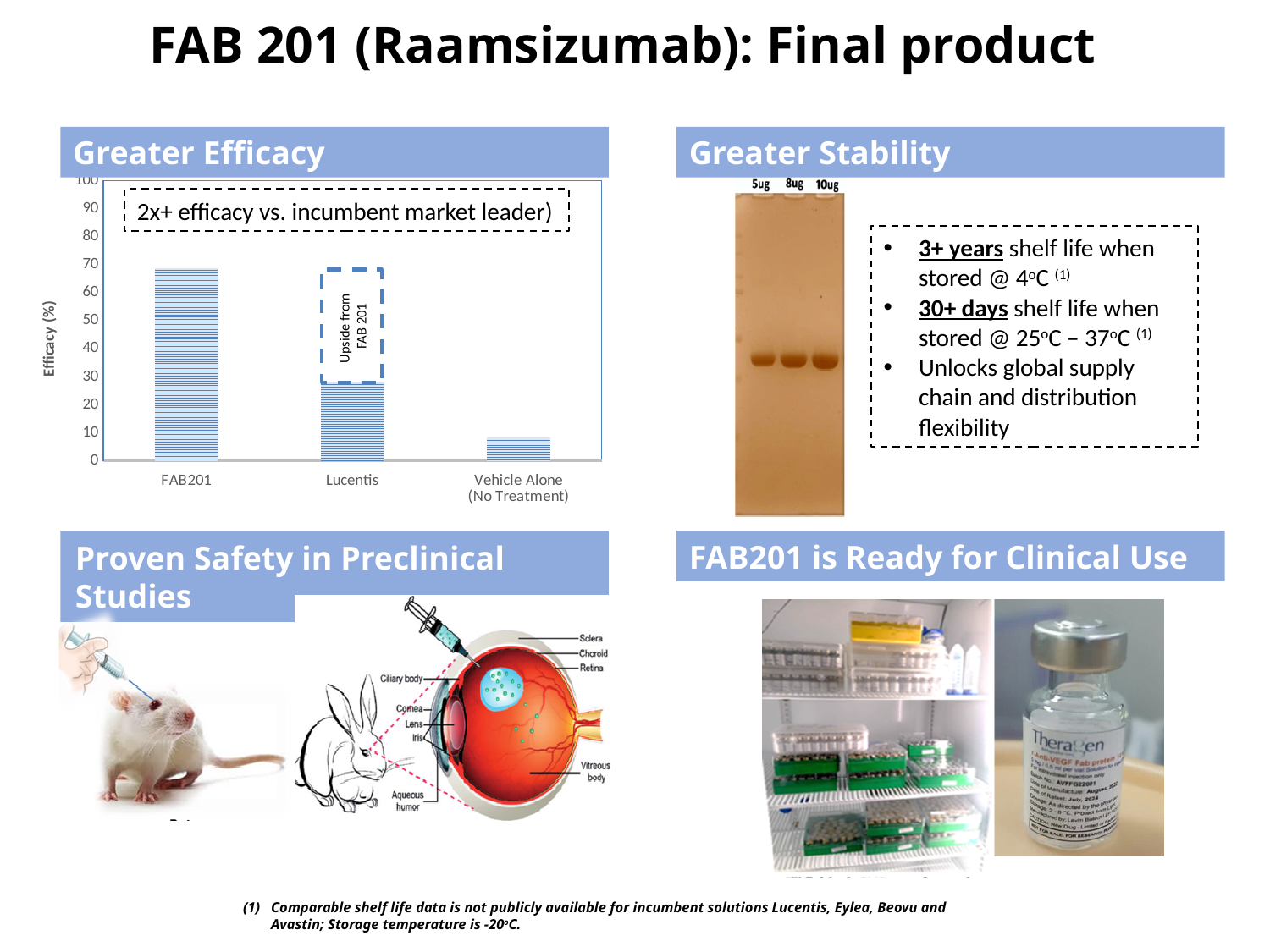
What kind of chart is shown under the "Greater Efficacy" heading? bar chart Is the efficacy value for FAB201 greater or less than 60? greater How many categories are plotted on the x axis of the efficacy chart? 3 Is the efficacy value for Vehicle Alone (No Treatment) greater or less than 20? less Which category has the highest efficacy in the chart? FAB201 What is the maximum value shown on the y axis of the efficacy chart? 100 What is the label of the y axis on the efficacy chart? Efficacy (%) Which category has the lowest efficacy in the chart? Vehicle Alone (No Treatment) Do the bar values rise or fall moving from left to right across the efficacy chart? fall Is the solid bar for Lucentis greater or less than 40? less Which has the higher plotted efficacy, FAB201 or Lucentis? FAB201